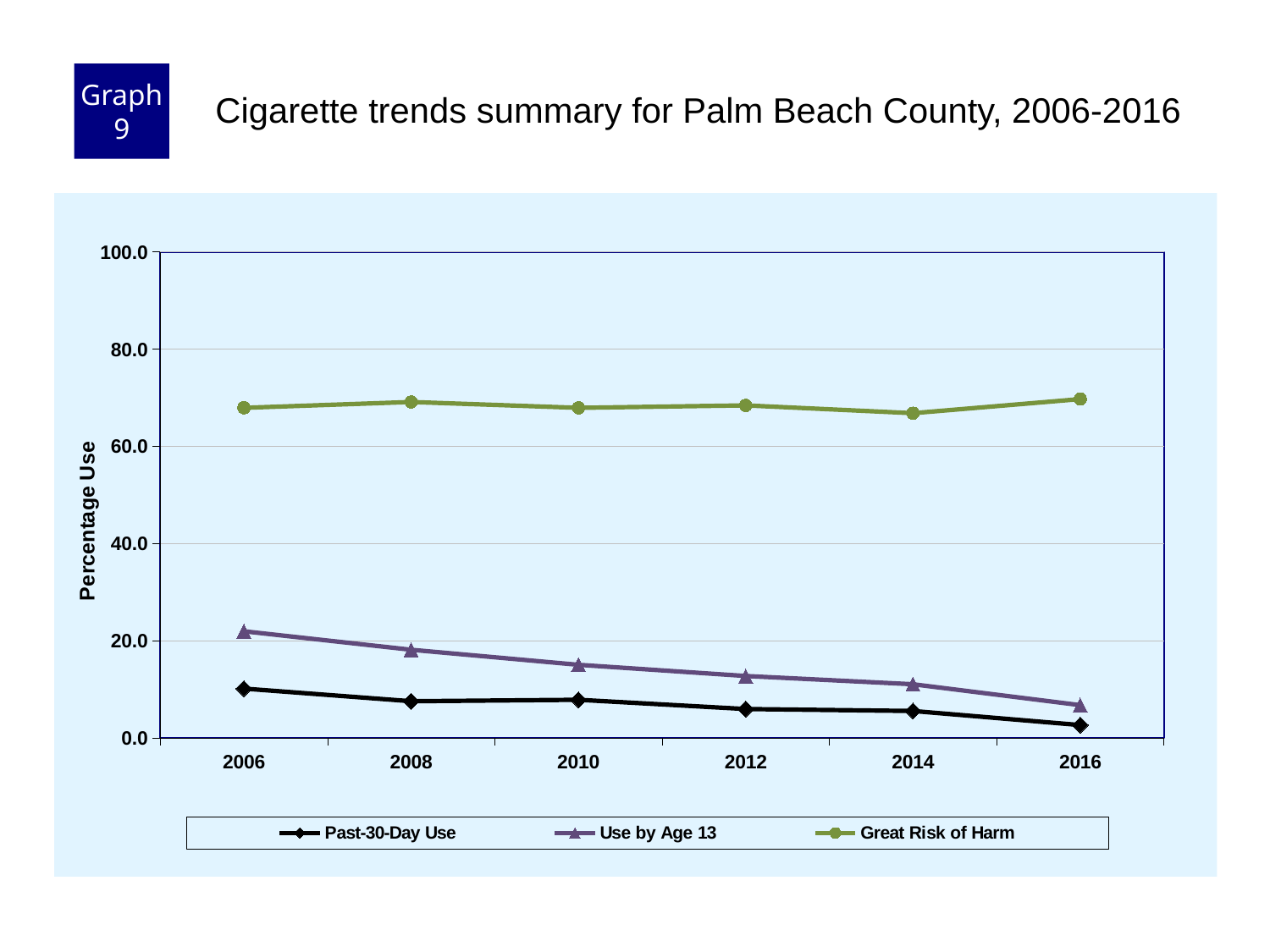
In which year is the Use by Age 13 value highest? 2006 Is the value for Use by Age 13 in 2016 greater or less than 20.0? less Does the Use by Age 13 series rise or fall from 2006 to 2016? fall How many years are plotted along the x axis? 6 Is the value for Great Risk of Harm in 2016 greater or less than 80.0? less Which series has the highest value in 2016? Great Risk of Harm In which year is the Past-30-Day Use value lowest? 2016 What kind of chart is shown on the slide? line chart Is the value for Great Risk of Harm in 2006 greater or less than 60.0? greater What is the title of the y axis? Percentage Use Which is larger in 2006, Use by Age 13 or Past-30-Day Use? Use by Age 13 How many series does the legend list? 3